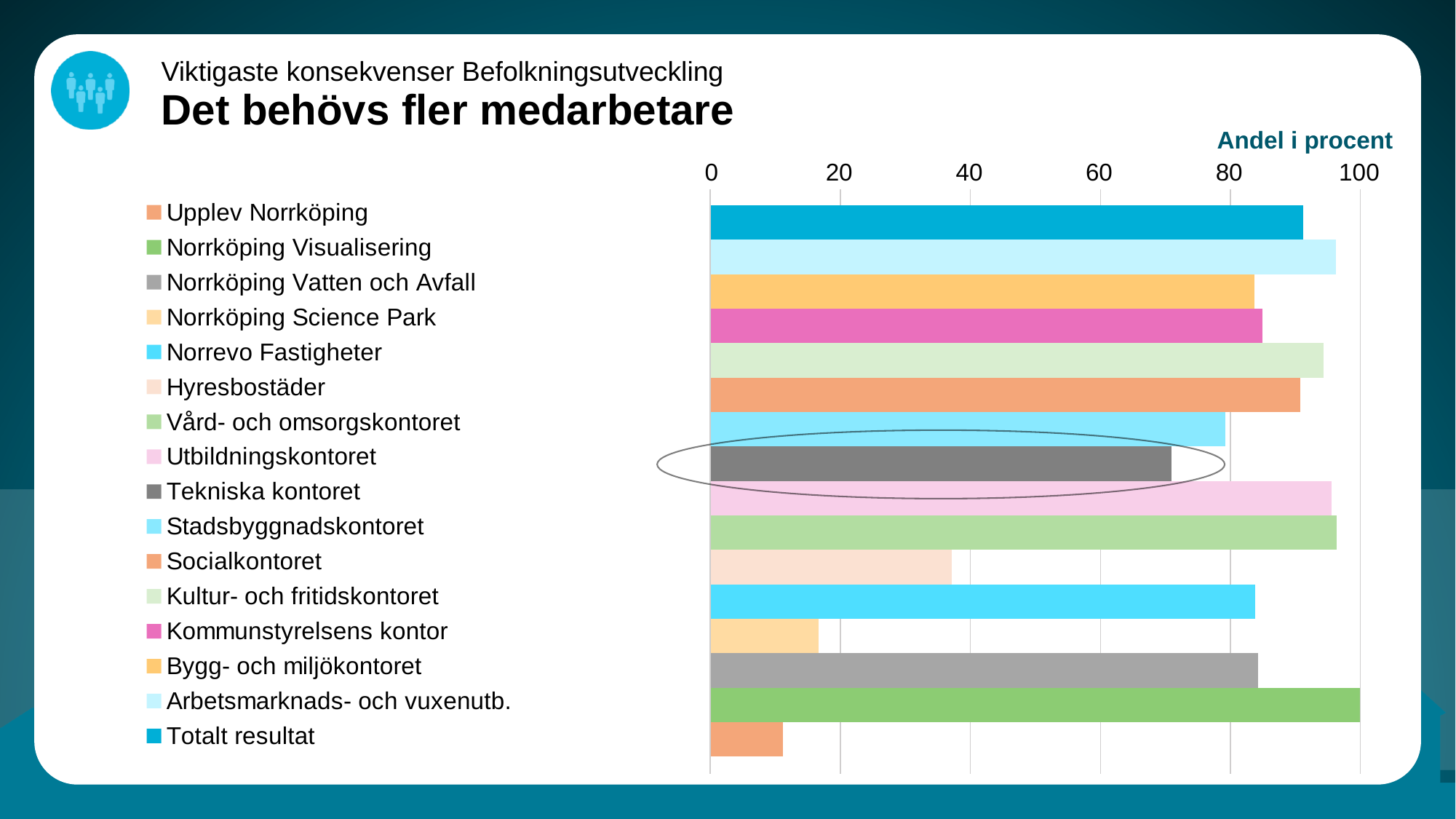
What is the value for Norrköping Visualisering? 100 What is the axis title shown above the horizontal axis? Andel i procent What kind of chart is shown on the slide? bar chart Is the value for Tekniska kontoret greater or less than 80? less How many entries does the legend list? 16 Is the value for Norrköping Science Park greater or less than 20? less Is the value for Hyresbostäder greater or less than 40? less Which category's bar is circled in the chart? Tekniska kontoret How many bars are plotted in the chart? 16 Which category has the highest value in the chart? Norrköping Visualisering Which is larger, the value for Hyresbostäder or the value for Socialkontoret? Socialkontoret Which category has the lowest value in the chart? Upplev Norrköping